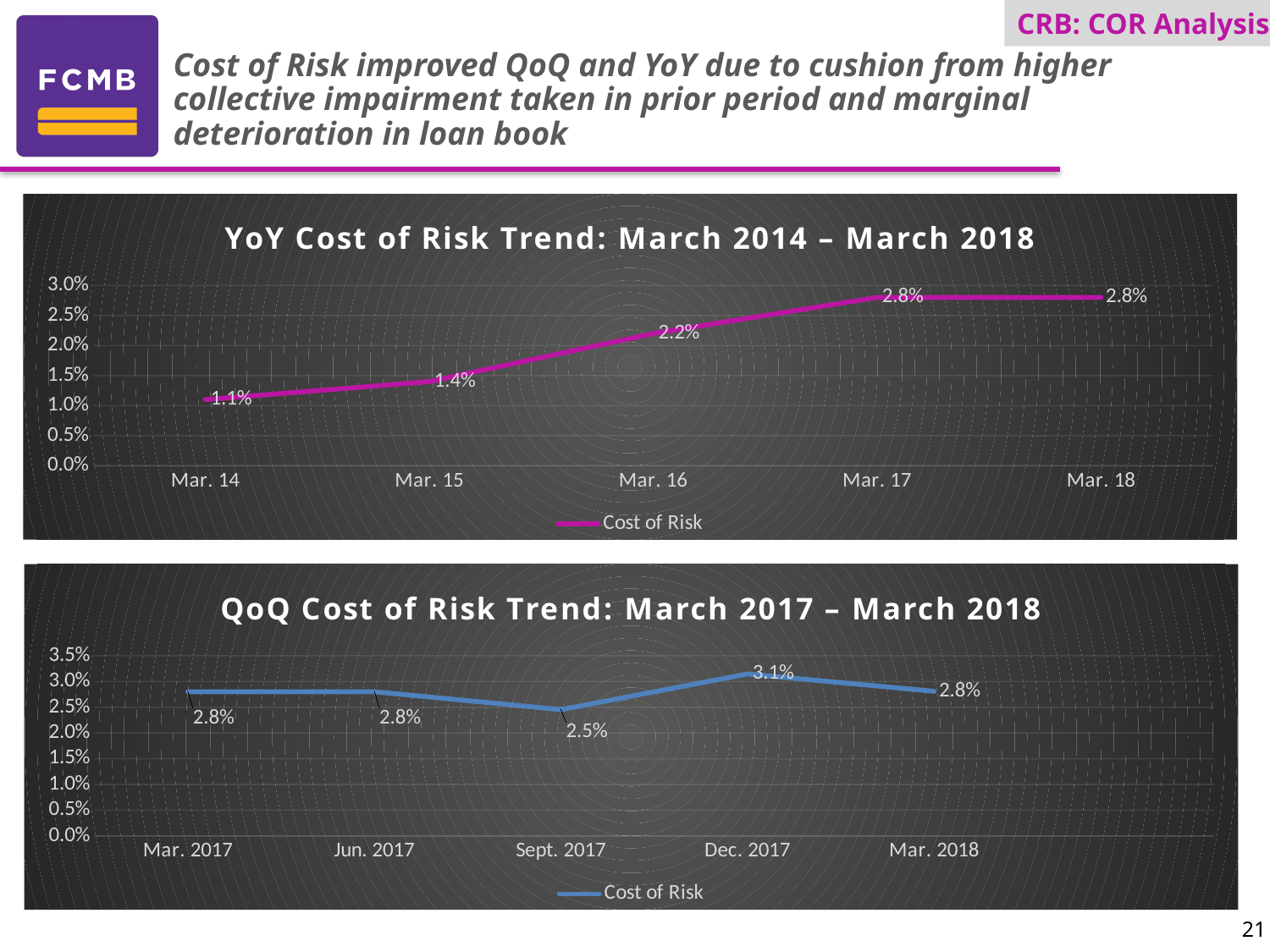
In the YoY Cost of Risk Trend chart, what is the difference between the values for Mar. 17 and Mar. 15? 1.4% In the QoQ Cost of Risk Trend chart, which is larger, the value for Dec. 2017 or the value for Mar. 2018? Dec. 2017 In the YoY Cost of Risk Trend chart, how many periods are plotted on the x axis? 5 In the YoY Cost of Risk Trend chart, what is the value for Mar. 14? 1.1% In the YoY Cost of Risk Trend chart, what is the value for Mar. 16? 2.2% How many series does the legend of the YoY Cost of Risk Trend chart list? 1 In the YoY Cost of Risk Trend chart, which period has the lowest cost of risk? Mar. 14 In the QoQ Cost of Risk Trend chart, what is the difference between the values for Dec. 2017 and Sept. 2017? 0.6% In the QoQ Cost of Risk Trend chart, which period has the highest cost of risk? Dec. 2017 In the QoQ Cost of Risk Trend chart, what is the value for Sept. 2017? 2.5% What type of chart is the QoQ Cost of Risk Trend chart? line chart In the YoY Cost of Risk Trend chart, do the values generally rise or fall from Mar. 14 to Mar. 18? rise